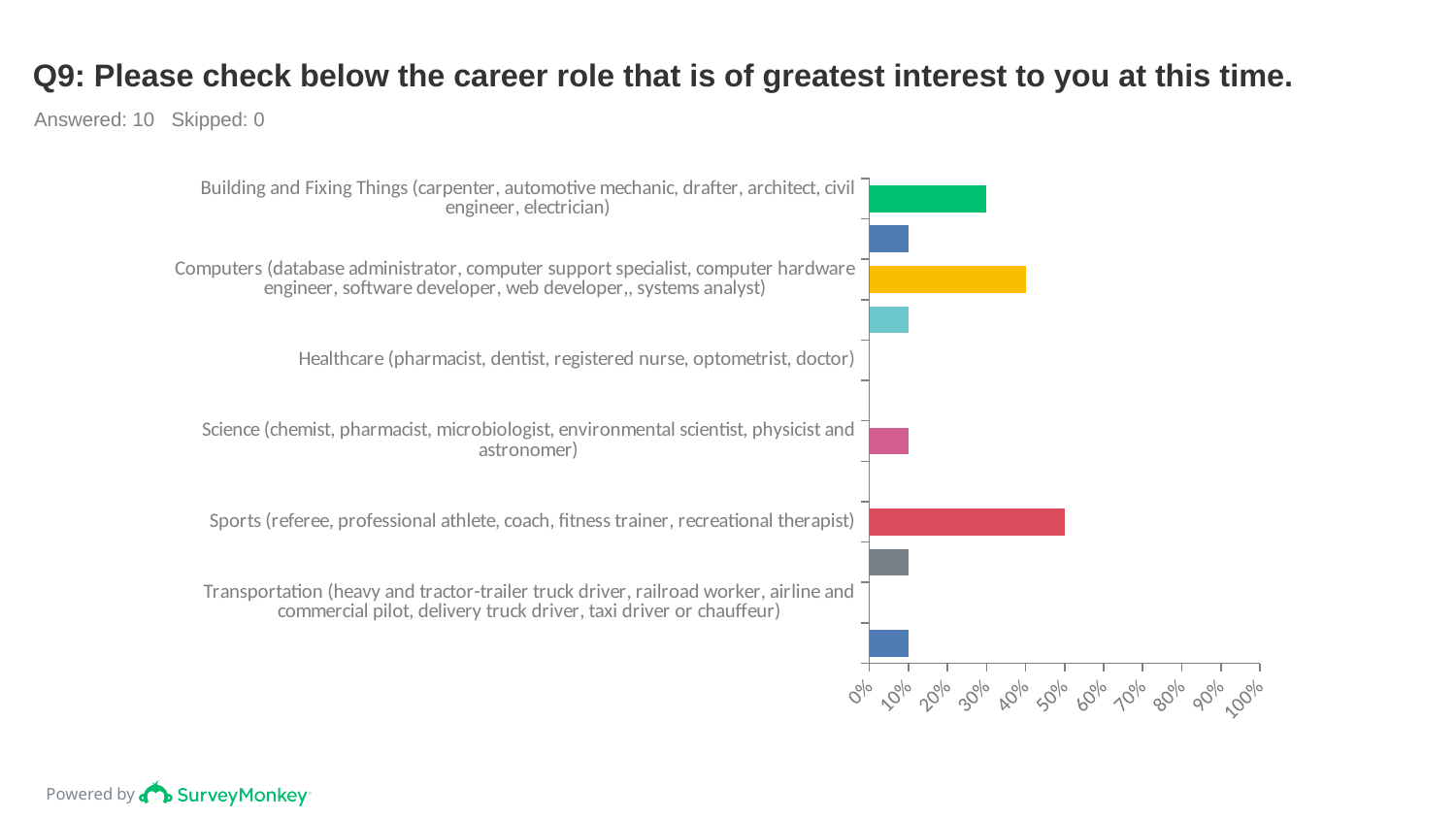
What type of chart is shown on the slide? bar chart What is the value for Computers (database administrator, computer support specialist, computer hardware engineer, software developer, web developer, systems analyst)? 40% What is the difference between the values for Sports and Computers? 10% What is the value for Sports (referee, professional athlete, coach, fitness trainer, recreational therapist)? 50% Which has a larger value, Science or Healthcare? Science What is the value for Science (chemist, pharmacist, microbiologist, environmental scientist, physicist and astronomer)? 10% Is the value for Building and Fixing Things greater or less than 20%? greater Which labeled career role has the highest value? Sports Which has a larger value, Computers or Building and Fixing Things? Computers What is the difference between the values for Computers and Science? 30% How many respondents answered this question according to the slide? 10 What is the value for Building and Fixing Things (carpenter, automotive mechanic, drafter, architect, civil engineer, electrician)? 30%